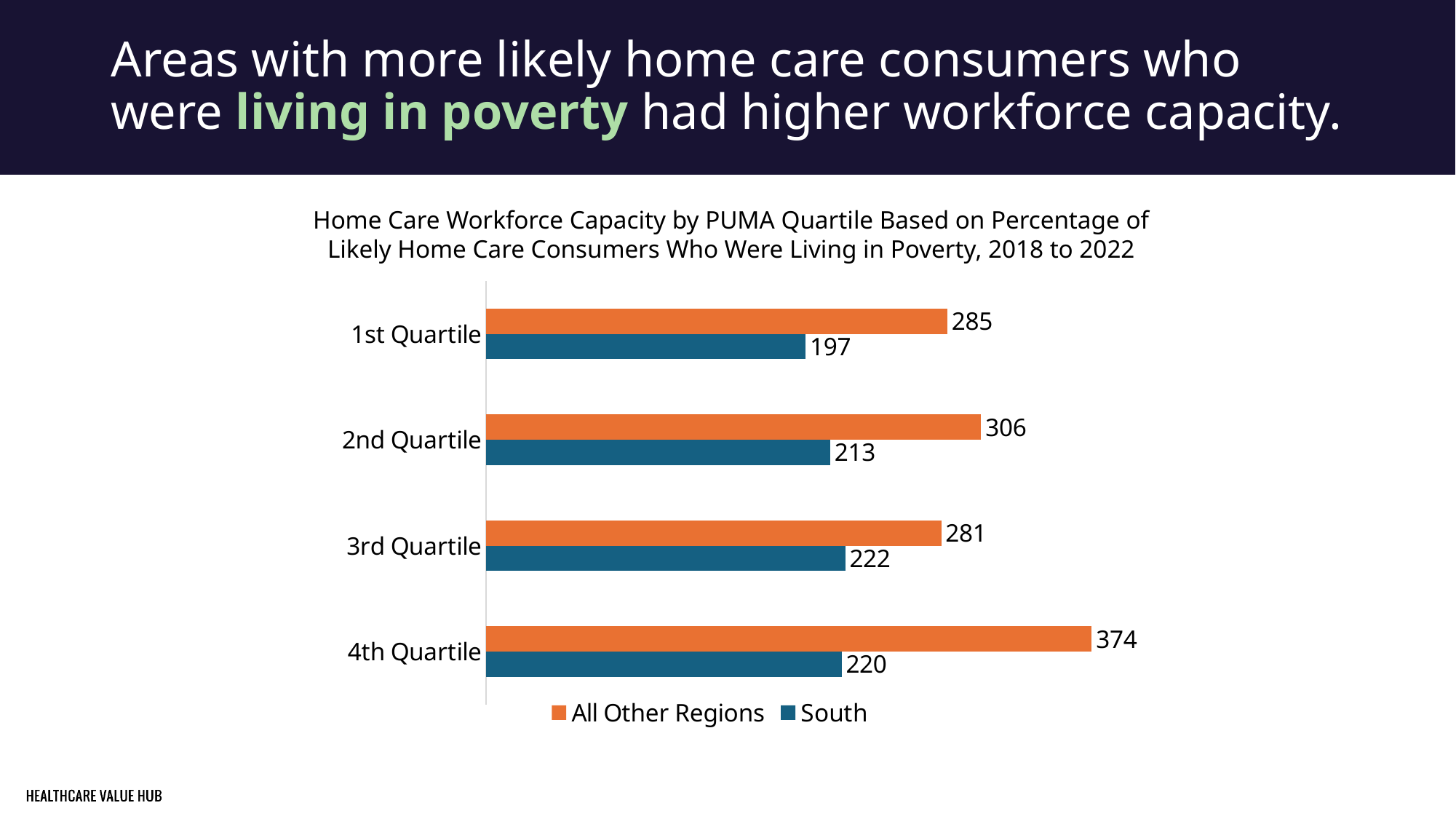
How many quartile categories are shown on the chart? 4 What is the difference between the 2nd Quartile and 1st Quartile values for All Other Regions? 21 What is the value for All Other Regions in the 2nd Quartile? 306 Which quartile has the lowest value for South? 1st Quartile Which is larger in the 3rd Quartile, All Other Regions or South? All Other Regions How many series does the legend list? 2 What is the value for South in the 3rd Quartile? 222 What kind of chart is shown on the slide? Bar chart What is the value for South in the 1st Quartile? 197 What is the difference between All Other Regions and South in the 4th Quartile? 154 What is the value for All Other Regions in the 4th Quartile? 374 Which quartile has the highest value for All Other Regions? 4th Quartile